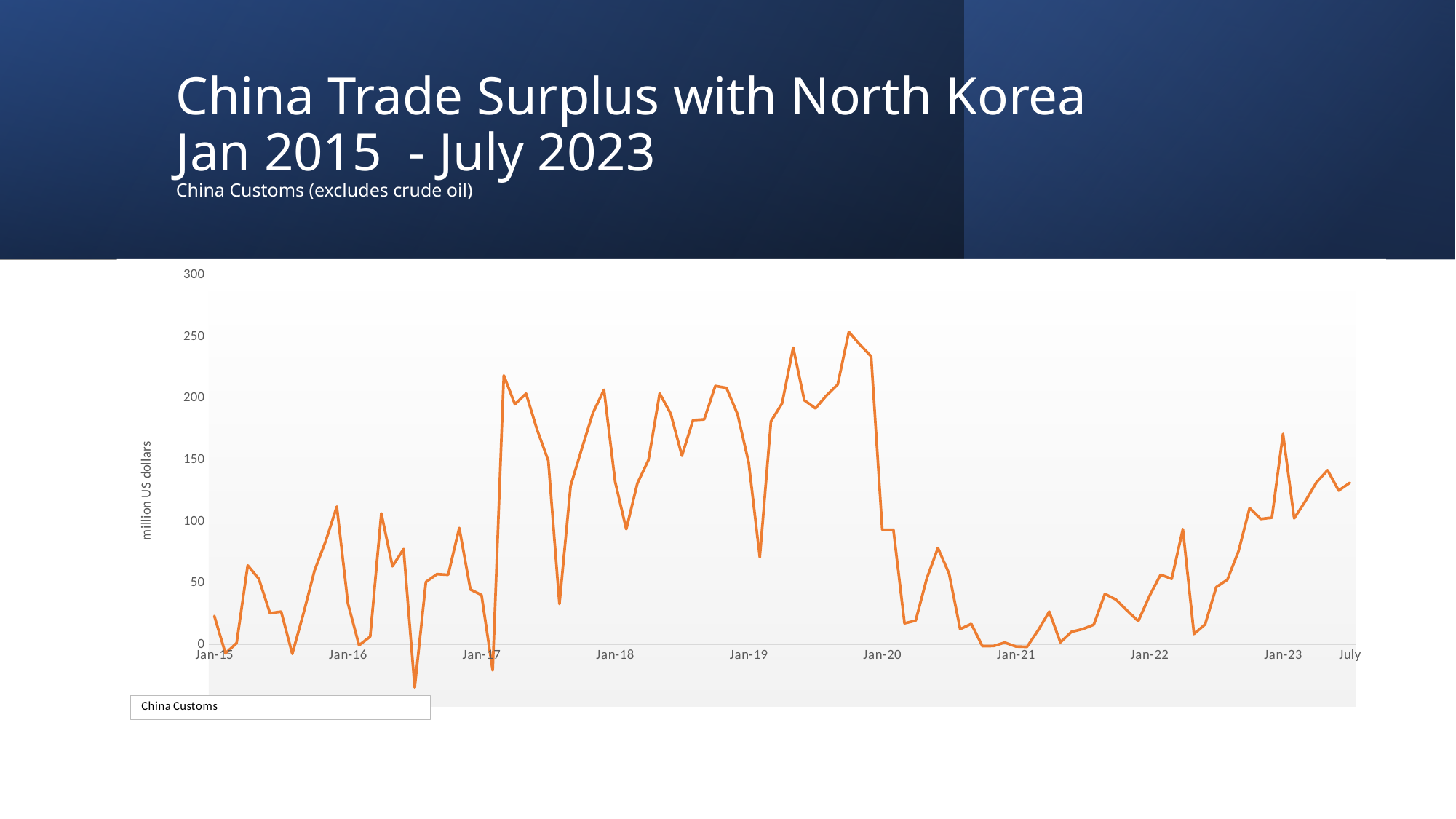
Is the value for Jan-22 greater or less than 50? less Is the value for July (2023) greater or less than 100? greater What kind of chart is shown on the slide? line chart Is the value for Jan-20 greater or less than 50? greater What is the label on the vertical axis of the chart? million US dollars Between Jan-20 and Jan-21, do the values generally rise or fall? fall What is the title of the chart on the slide? China Trade Surplus with North Korea Jan 2015 - July 2023 Between Jan-21 and Jan-23, do the values generally rise or fall? rise